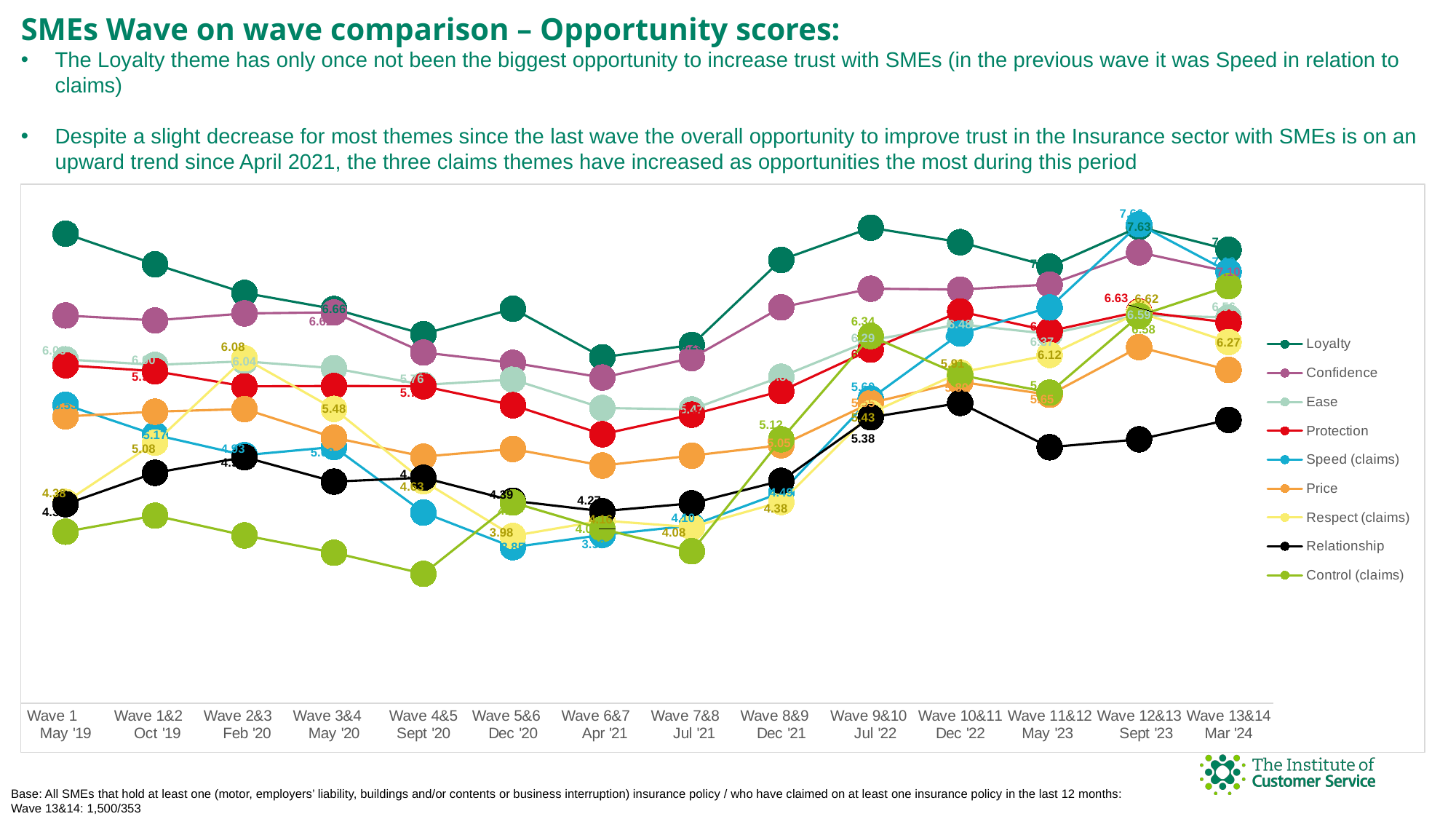
What is the Speed (claims) score at Wave 12&13 Sept '23? 7.66 What kind of chart is shown on the slide? line chart Which series has the highest score at Wave 1 May '19? Loyalty What is the Respect (claims) score at Wave 13&14 Mar '24? 6.27 What is the difference between the Speed (claims) and Protection scores at Wave 12&13 Sept '23? 1.03 What is the Respect (claims) score at Wave 2&3 Feb '20? 6.08 How many waves are shown along the x axis? 14 What is the Protection score at Wave 12&13 Sept '23? 6.63 How many series does the legend list? 9 What is the Relationship score at Wave 9&10 Jul '22? 5.38 Which series has the lowest score at Wave 4&5 Sept '20? Control (claims) Does the Loyalty score rise or fall from Wave 1 May '19 to Wave 4&5 Sept '20? fall